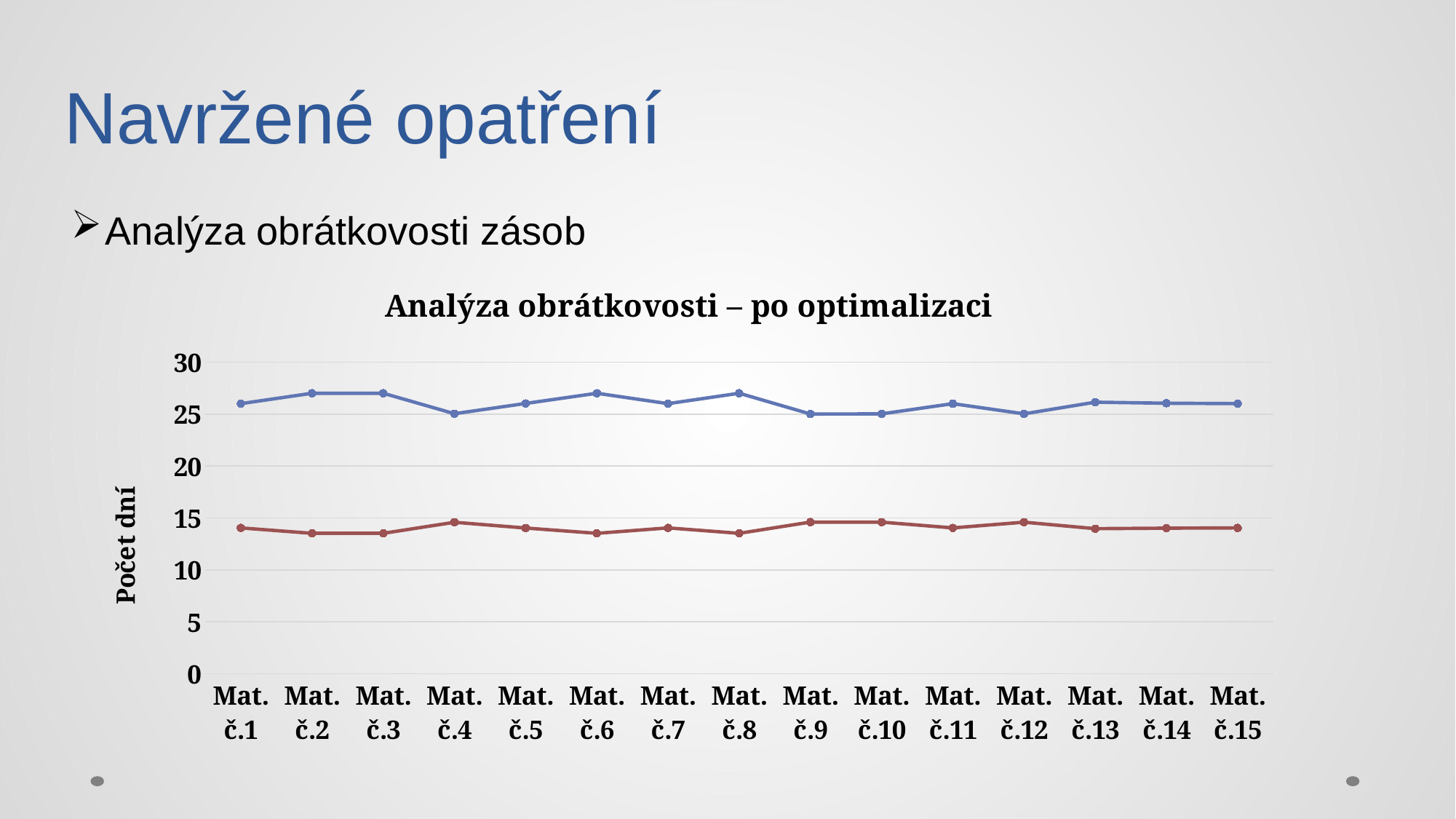
Is the value of the red line for Mat. č.3 greater or less than 15? less How many categories are shown on the x axis? 15 Is the value of the blue line for Mat. č.6 greater or less than 20? greater At Mat. č.5, which line has the higher value, the blue line or the red line? the blue line What is the title of the chart? Analýza obrátkovosti – po optimalizaci Is the value of the red line for Mat. č.9 greater or less than 10? greater How many data series (lines) are plotted on the chart? 2 What is the label of the vertical axis? Počet dní At Mat. č.12, which line has the lower value, the blue line or the red line? the red line What kind of chart is shown on the slide? line chart